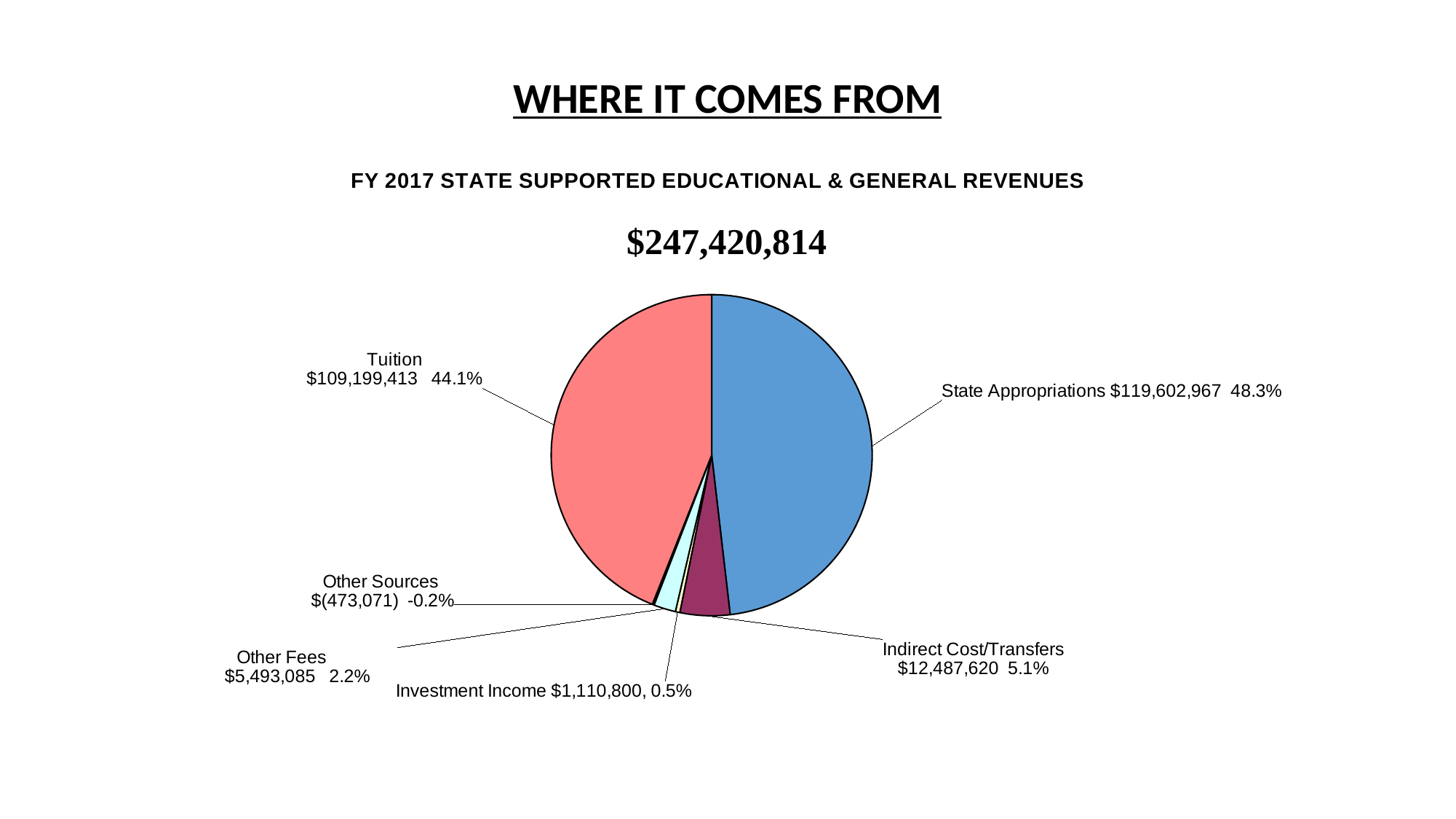
Which is larger, Indirect Cost/Transfers or Other Fees? Indirect Cost/Transfers Which category has the largest share of the pie? State Appropriations Which category has the smallest share of the pie? Other Sources What is the dollar value for State Appropriations? $119,602,967 What is the dollar value for Tuition? $109,199,413 What total amount is shown above the pie chart? $247,420,814 What kind of chart is shown on the slide? Pie chart What is the difference in percentage share between State Appropriations and Tuition? 4.2% What share of the pie does Indirect Cost/Transfers represent? 5.1% What share of the pie does Other Fees represent? 2.2% How many categories are shown in the pie chart? 6 What is the dollar value for Investment Income? $1,110,800